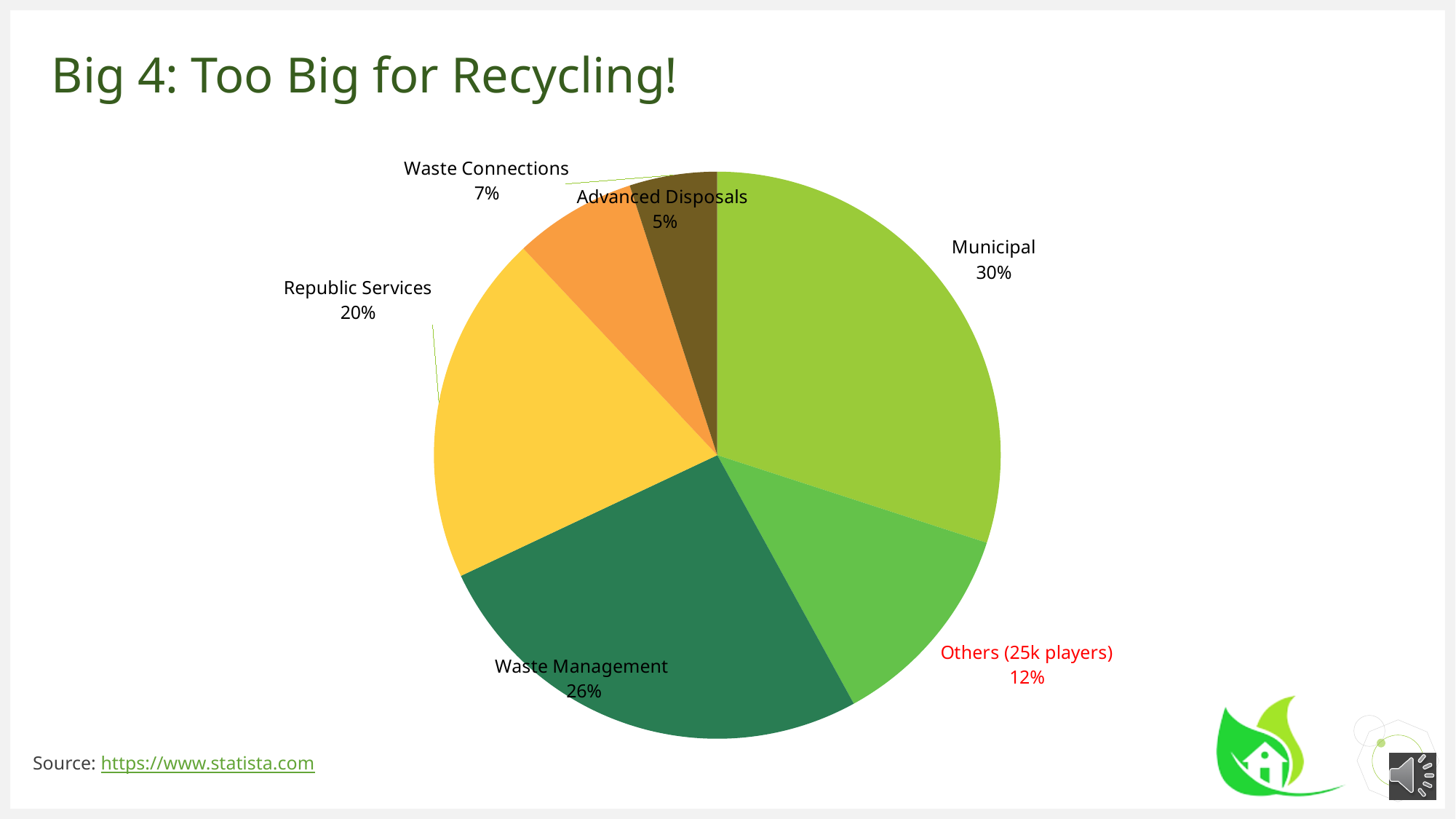
What is the title of the slide containing the pie chart? Big 4: Too Big for Recycling! What is the value shown for Advanced Disposals? 5% How many slices does the pie chart have? 6 What kind of chart is shown on the slide? pie chart What is the value shown for Waste Management? 26% Which is larger, Republic Services or Waste Connections? Republic Services What is the value shown for Republic Services? 20% What is the difference between the Municipal and Waste Management shares? 4% Which slice of the pie is the smallest? Advanced Disposals Which slice of the pie is the largest? Municipal What is the value shown for Others (25k players)? 12% What share of the pie does Municipal hold? 30%